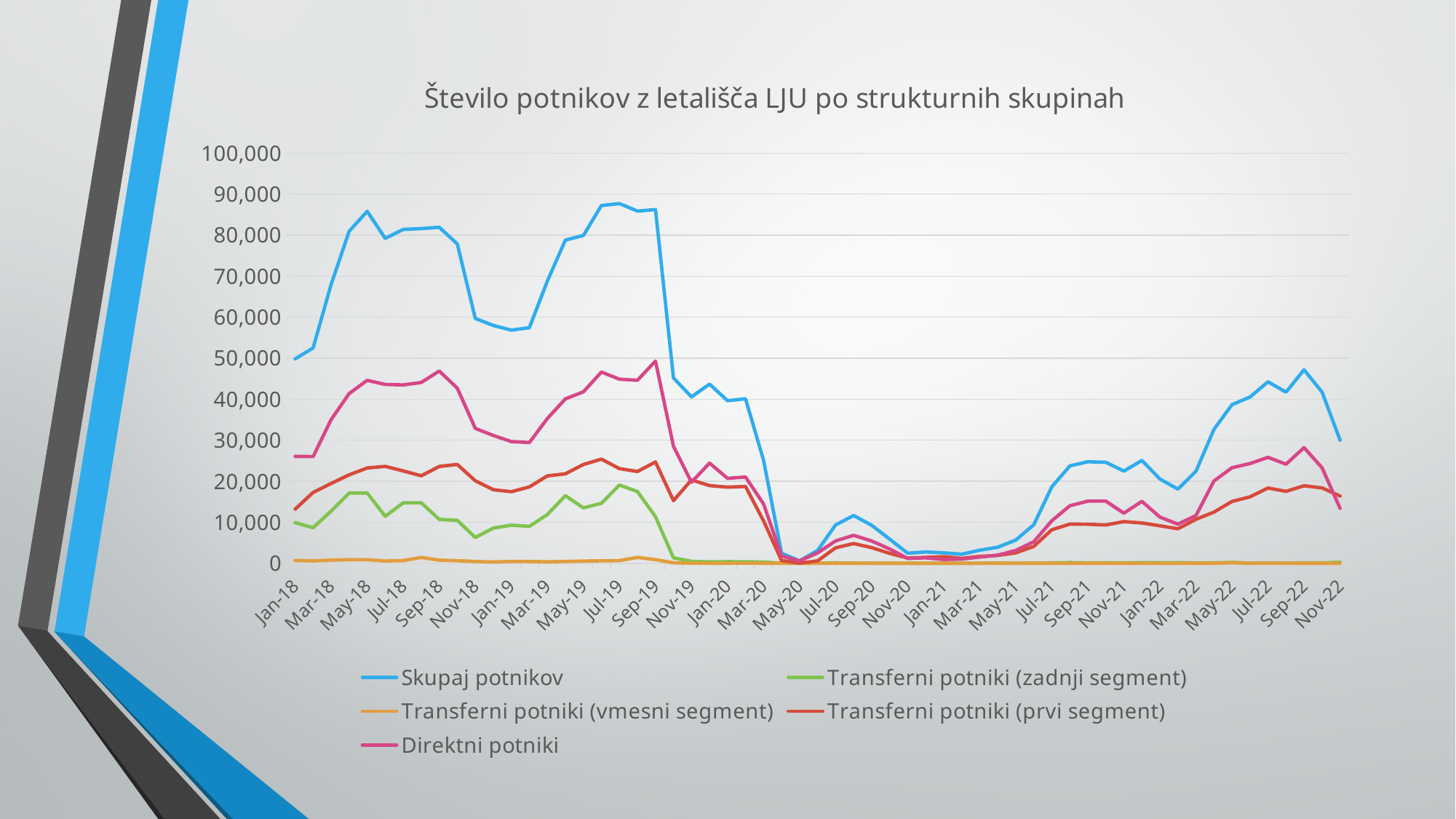
Is the value for Direktni potniki in Sep-19 greater or less than 40,000? greater In Sep-19, which is larger: Direktni potniki or Transferni potniki (prvi segment)? Direktni potniki What colour is the line for Skupaj potnikov? blue What is the title of the chart? Število potnikov z letališča LJU po strukturnih skupinah Is the value for Skupaj potnikov in May-20 greater or less than 10,000? less Is the value for Transferni potniki (zadnji segment) in May-18 greater or less than 10,000? greater Which series stays lowest, close to zero, across the whole period? Transferni potniki (vmesni segment) Which series has the highest values throughout the chart? Skupaj potnikov How many series does the legend list? 5 Does the Skupaj potnikov line rise or fall between Sep-19 and May-20? fall What kind of chart is shown on the slide? line chart